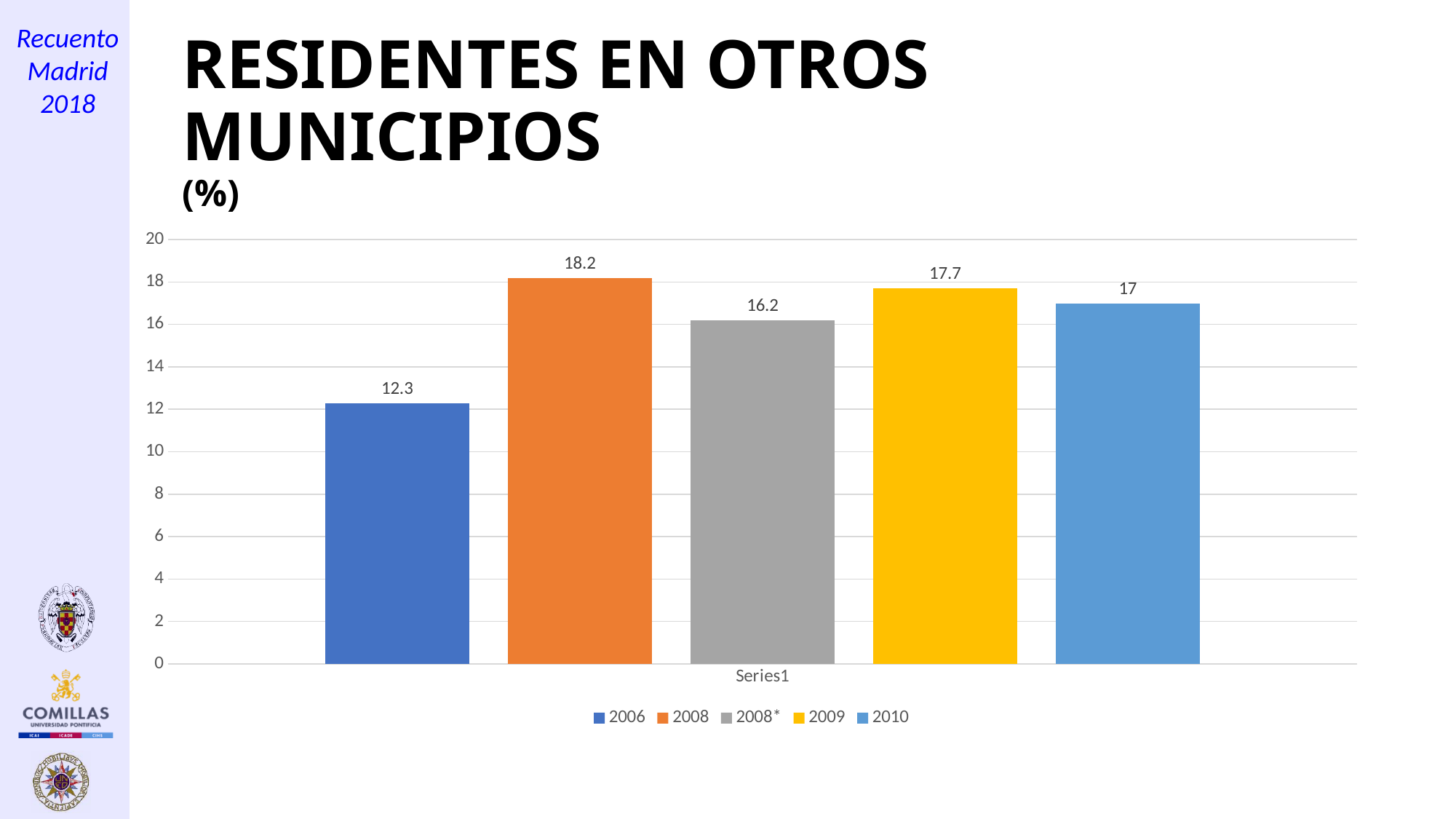
Which year has the highest value? 2008 What is the value for 2010? 17 Is the value for 2008* greater or less than 14? greater Which is larger, the value for 2009 or the value for 2010? 2009 Which year has the lowest value? 2006 What is the difference between the values for 2008 and 2006? 5.9 What is the value for 2008*? 16.2 What kind of chart is shown on the slide? Bar chart What is the value for 2006? 12.3 What is the value for 2008? 18.2 How many bars are shown in the chart? 5 How many entries does the legend list? 5